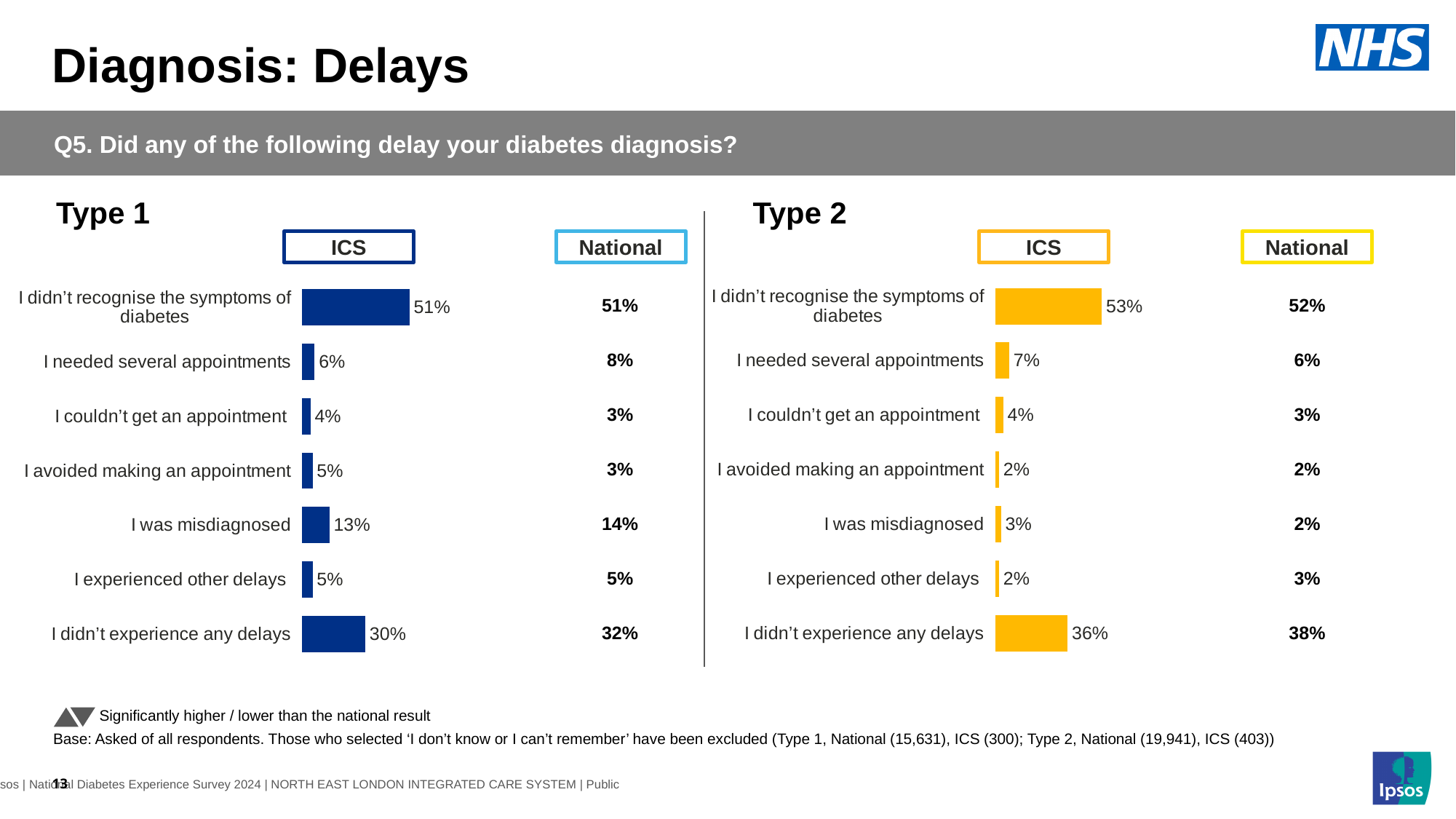
In the Type 1 chart, what is the National value for "I was misdiagnosed"? 14% In the Type 1 chart, what is the ICS value for "I didn't recognise the symptoms of diabetes"? 51% In the Type 2 chart, what is the ICS value for "I didn't experience any delays"? 36% In the Type 1 chart, what is the difference between the ICS and National values for "I didn't experience any delays"? 2 percentage points In the Type 2 chart, what is the difference between the ICS values for "I didn't recognise the symptoms of diabetes" and "I didn't experience any delays"? 17 percentage points In the Type 2 chart, which category has the highest ICS value? I didn't recognise the symptoms of diabetes How many categories are shown in the Type 1 chart? 7 In the Type 1 chart, which category has the highest ICS value? I didn't recognise the symptoms of diabetes In the Type 1 chart, is the ICS value for "I was misdiagnosed" larger or smaller than the ICS value for "I needed several appointments"? larger What kind of chart is used to show the ICS values in the Type 1 and Type 2 charts? bar chart In the Type 2 chart, is the ICS value for "I needed several appointments" larger or smaller than the National value for the same category? larger In the Type 2 chart, what is the National value for "I needed several appointments"? 6%